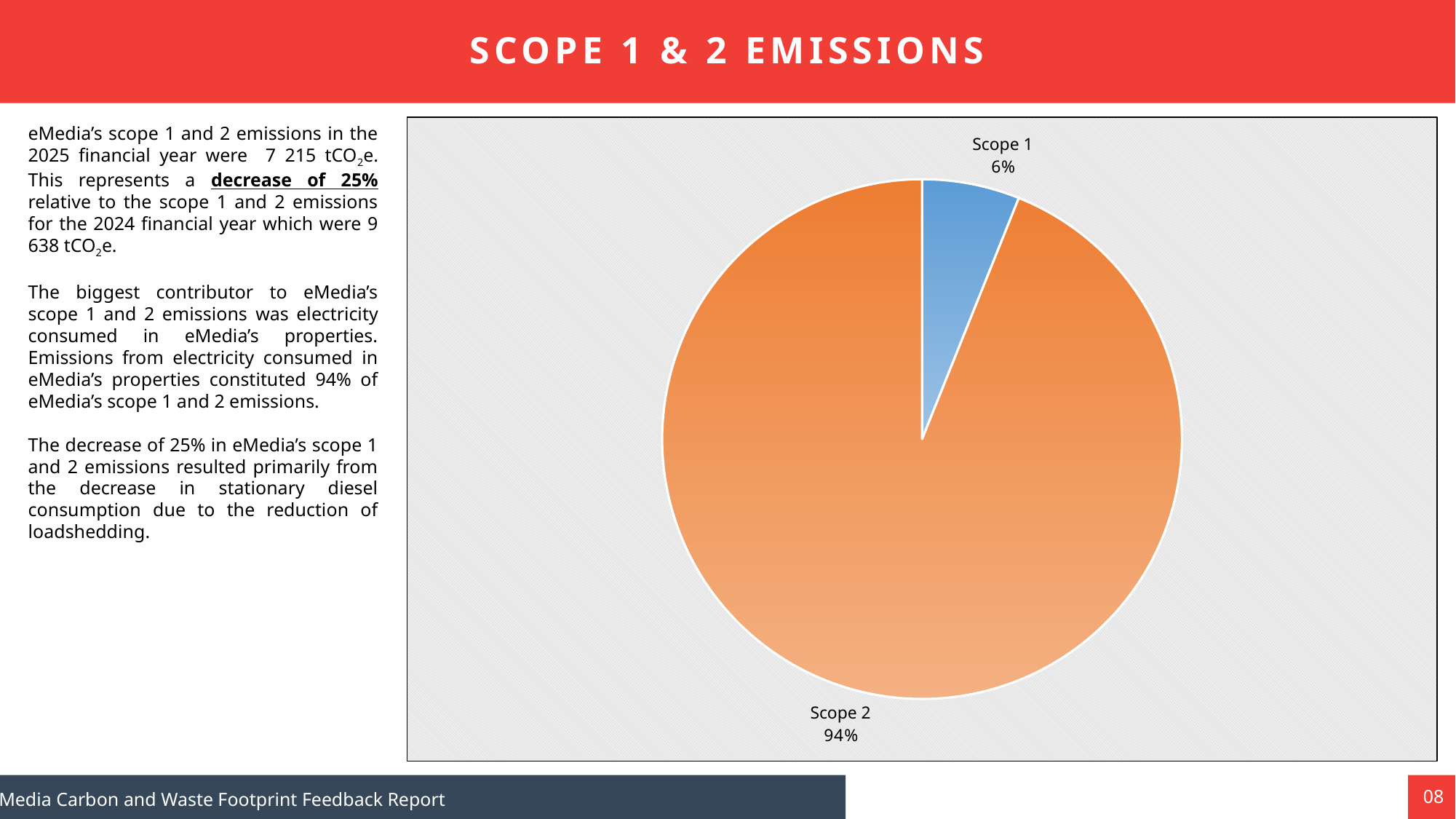
Which slice of the pie chart is the largest? Scope 2 What colour is the Scope 2 slice? Orange Which slice of the pie chart is the smallest? Scope 1 What share of the pie does Scope 1 represent? 6% What colour is the Scope 1 slice? Blue How many slices does the pie chart have? 2 What is the difference in percentage points between the Scope 2 and Scope 1 slices? 88 What kind of chart is shown on the slide? Pie chart What share of the pie does Scope 2 represent? 94% Which is larger, the Scope 1 slice or the Scope 2 slice? Scope 2